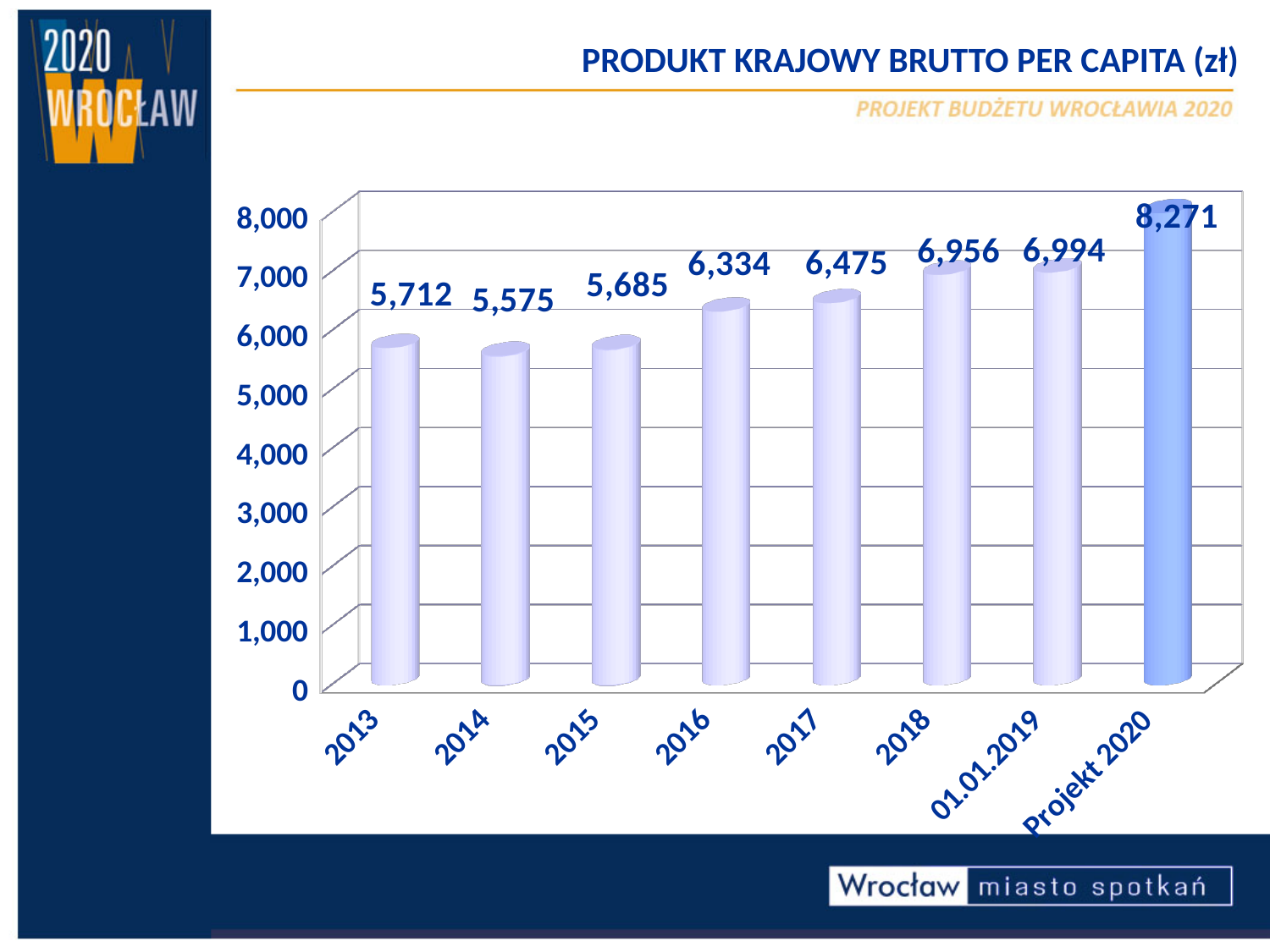
What is the value for Projekt 2020? 8,271 What kind of chart is shown on the slide? bar chart What is the value for 2013? 5,712 What is the value for 2016? 6,334 Which category has the lowest value? 2014 What is the difference between the values for 2018 and 2017? 481 What is the difference between the values for Projekt 2020 and 01.01.2019? 1,277 What is the value for 01.01.2019? 6,994 How many categories are shown on the x axis? 8 Which category has the highest value? Projekt 2020 What is the title of the chart? PRODUKT KRAJOWY BRUTTO PER CAPITA (zł) Which is larger, the value for 2015 or the value for 2016? 2016